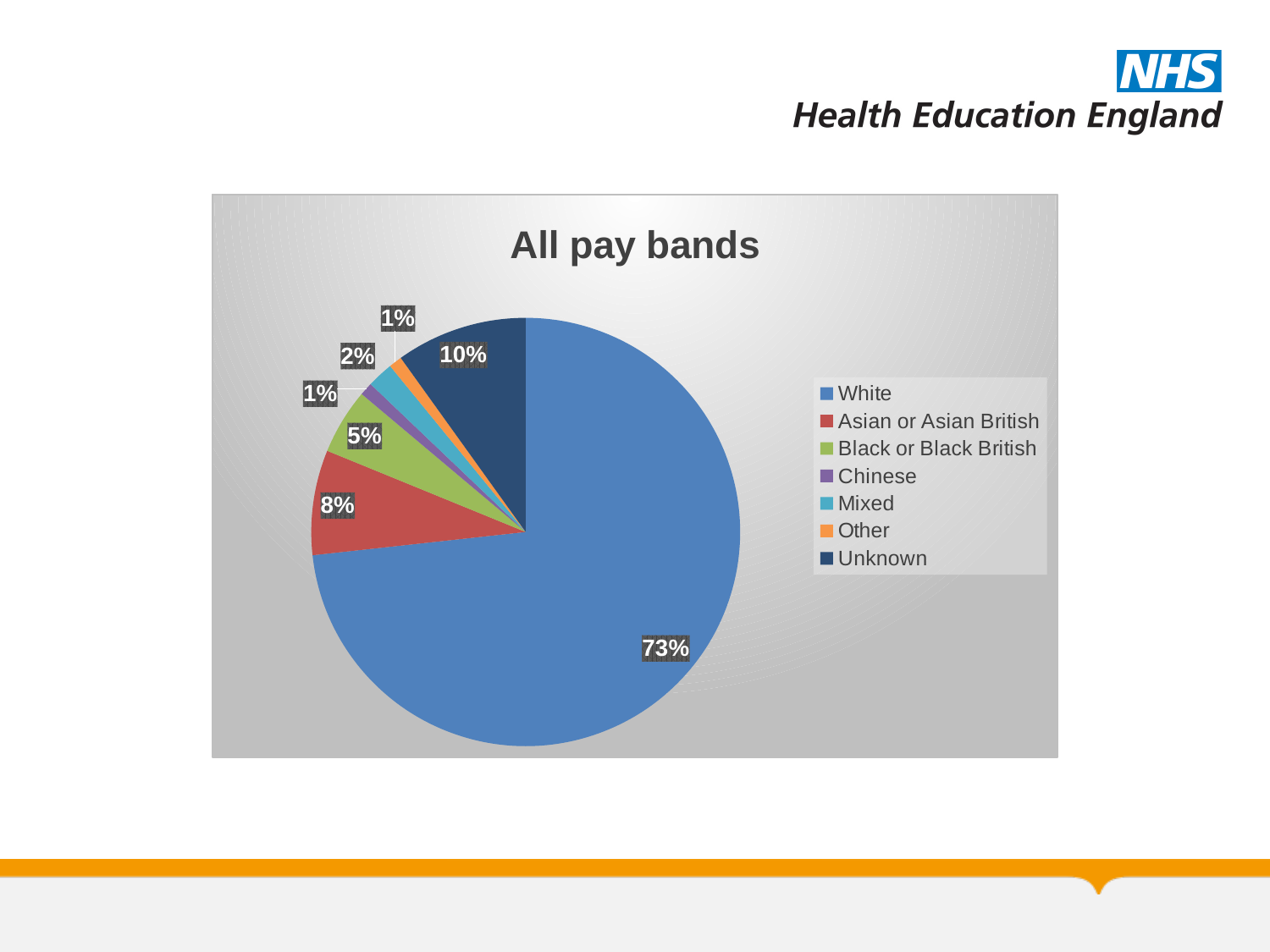
What is the title of the chart? All pay bands What percentage of the pie is Mixed? 2% What percentage of the pie is Black or Black British? 5% What percentage of the pie is Asian or Asian British? 8% What percentage of the pie is White? 73% What is the difference between the White share and the Unknown share? 63% What colour is the slice for Unknown? dark navy blue What percentage of the pie is Unknown? 10% Which is larger, the share for Unknown or the share for Asian or Asian British? Unknown How many categories does the legend list? 7 Which category has the largest share of the pie? White What type of chart is shown on the slide? pie chart